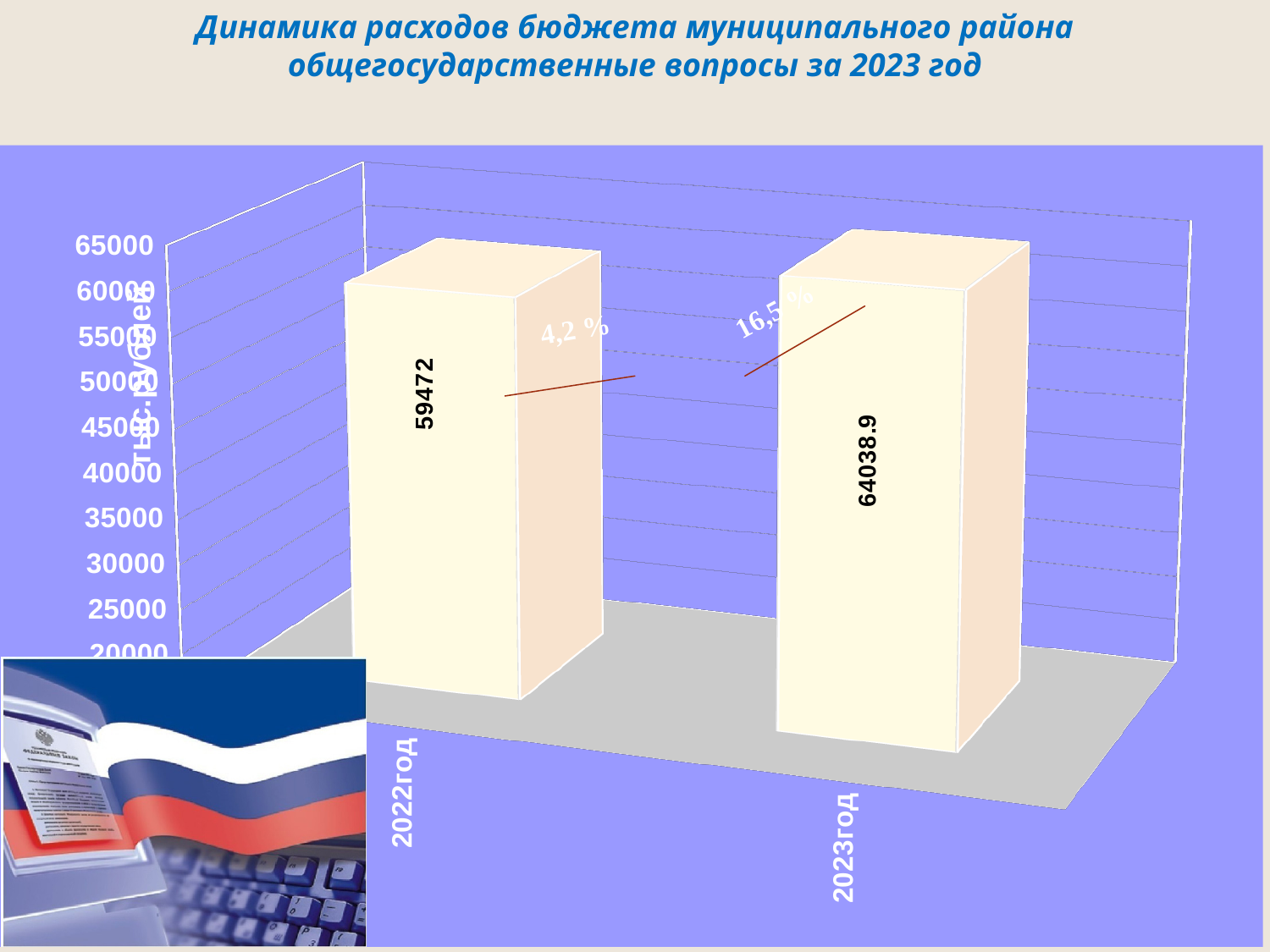
What is the difference between the values for 2023год and 2022год? 4566.9 What percentage annotation is shown next to the 2023год bar? 16,5 % What kind of chart is shown on the slide? bar chart Which year has the lower value? 2022год Is the value for 2023год greater or less than 60000? greater Which year has the higher value? 2023год What is the value for 2022год? 59472 How many bars are shown in the chart? 2 What is the value for 2023год? 64038.9 Is the value for 2022год larger or smaller than the value for 2023год? smaller Do the values rise or fall from 2022год to 2023год? rise Is the value for 2022год greater or less than 55000? greater